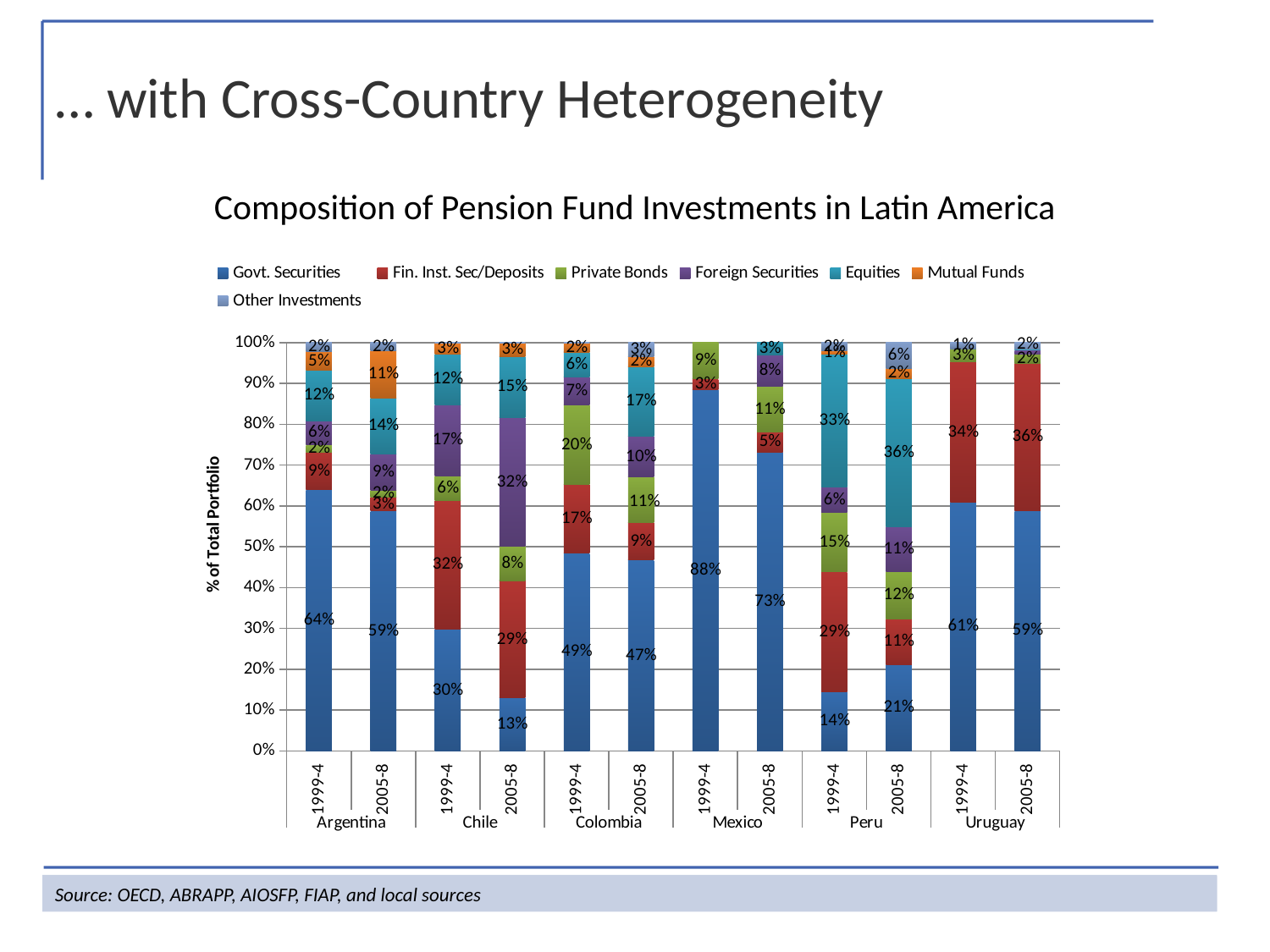
How many bars are plotted in the chart? 12 Which is larger: the Fin. Inst. Sec/Deposits share for Uruguay in 2005-8 or for Chile in 2005-8? Uruguay 2005-8 How many series does the legend list? 7 What is the Equities share for Peru in 2005-8? 36% What type of chart is shown on the slide? Stacked bar chart What is the Foreign Securities share for Chile in 2005-8? 32% Which bar has the lowest Govt. Securities share? Chile 2005-8 What is the Govt. Securities share for Mexico in 1999-4? 88% What is the label on the vertical axis? % of Total Portfolio By how many percentage points did the Govt. Securities share for Chile fall from 1999-4 to 2005-8? 17 Did the Govt. Securities share for Peru rise or fall from 1999-4 to 2005-8? Rise Which bar has the highest Govt. Securities share? Mexico 1999-4